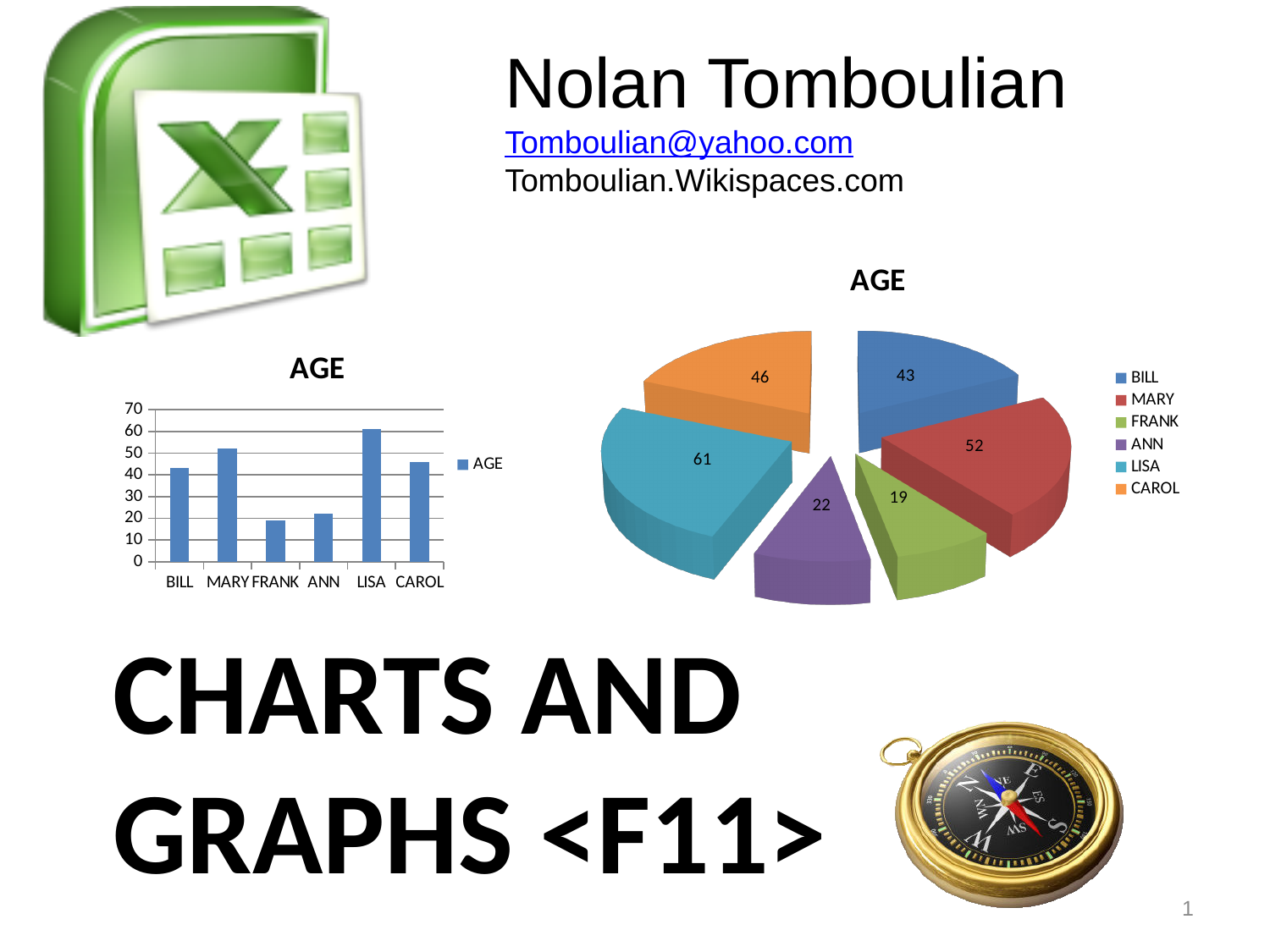
In the pie chart, how many slices are there? 6 In the pie chart, what is the difference between LISA's value and ANN's value? 39 What is the title of the chart on the right? AGE In the pie chart, what is the value for FRANK? 19 In the bar chart on the left, which of MARY or CAROL has the taller bar? MARY In the pie chart, what is the value for MARY? 52 In the pie chart, which person has the largest slice? LISA What type of chart is the chart on the left? bar chart In the pie chart, how many entries does the legend list? 6 In the pie chart, which person has the smallest slice? FRANK